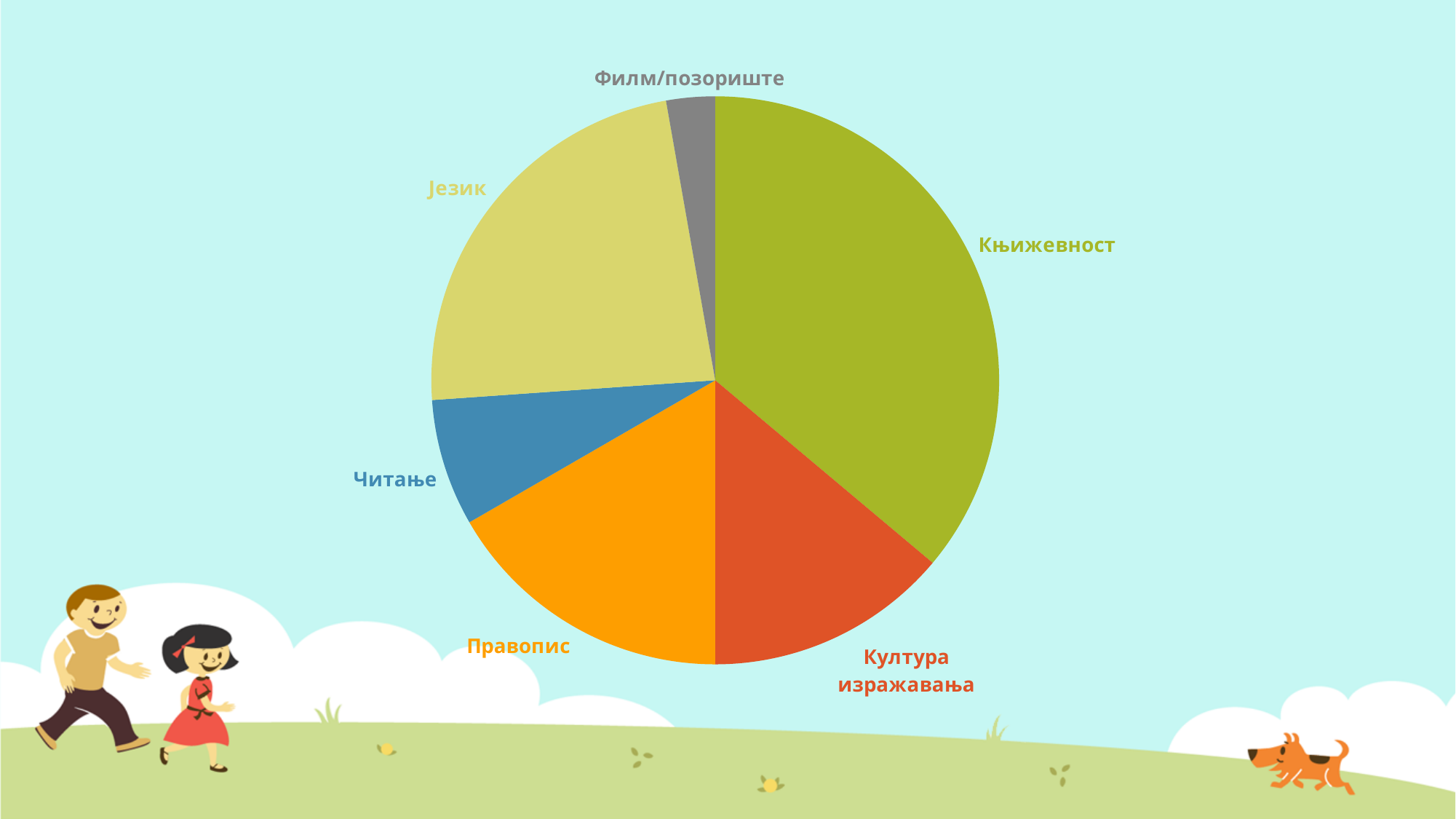
What colour is the Читање slice of the pie chart? blue Which slice is larger, Језик or Читање? Језик Which category has the smallest slice of the pie chart? Филм/позориште Which slice is larger, Правопис or Филм/позориште? Правопис What kind of chart is shown on the slide? pie chart Which slice is larger, Језик or Правопис? Језик How many slices does the pie chart have? 6 What colour is the Филм/позориште slice of the pie chart? gray Which category has the largest slice of the pie chart? Књижевност